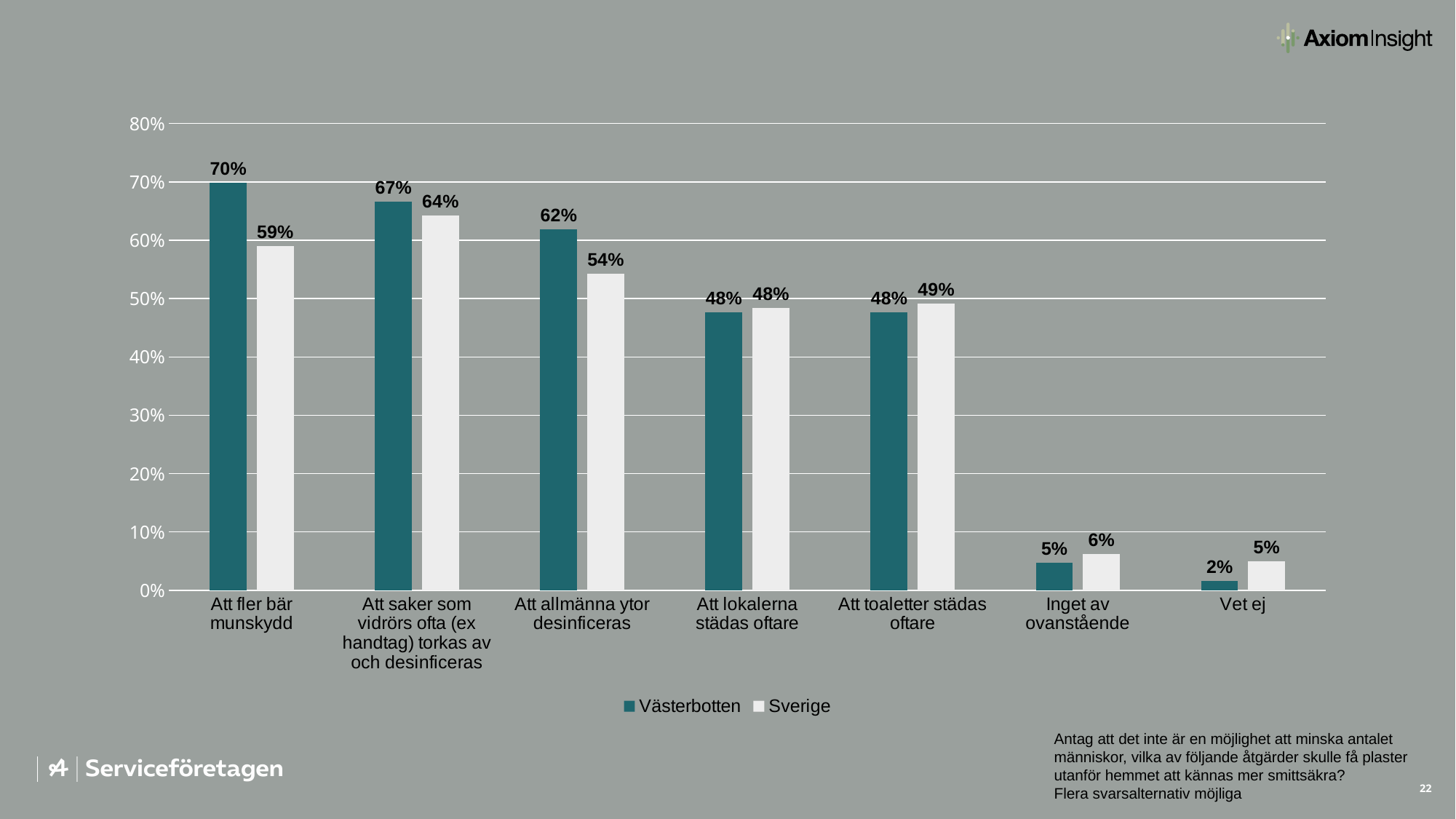
What is the difference between the Västerbotten and Sverige values for 'Att fler bär munskydd'? 11 percentage points Which is larger for 'Att saker som vidrörs ofta (ex handtag) torkas av och desinficeras': Västerbotten or Sverige? Västerbotten What kind of chart is shown on the slide? Bar chart How many series does the legend list? 2 How many categories are shown on the x axis? 7 What is the value for Västerbotten for 'Vet ej'? 2% What is the value for Sverige for 'Att allmänna ytor desinficeras'? 54% Which series is shown in dark teal in the legend? Västerbotten Which category has the lowest value for Västerbotten? Vet ej Which category has the highest value for Västerbotten? Att fler bär munskydd What is the value for Sverige for 'Inget av ovanstående'? 6% What is the value for Västerbotten for 'Att fler bär munskydd'? 70%